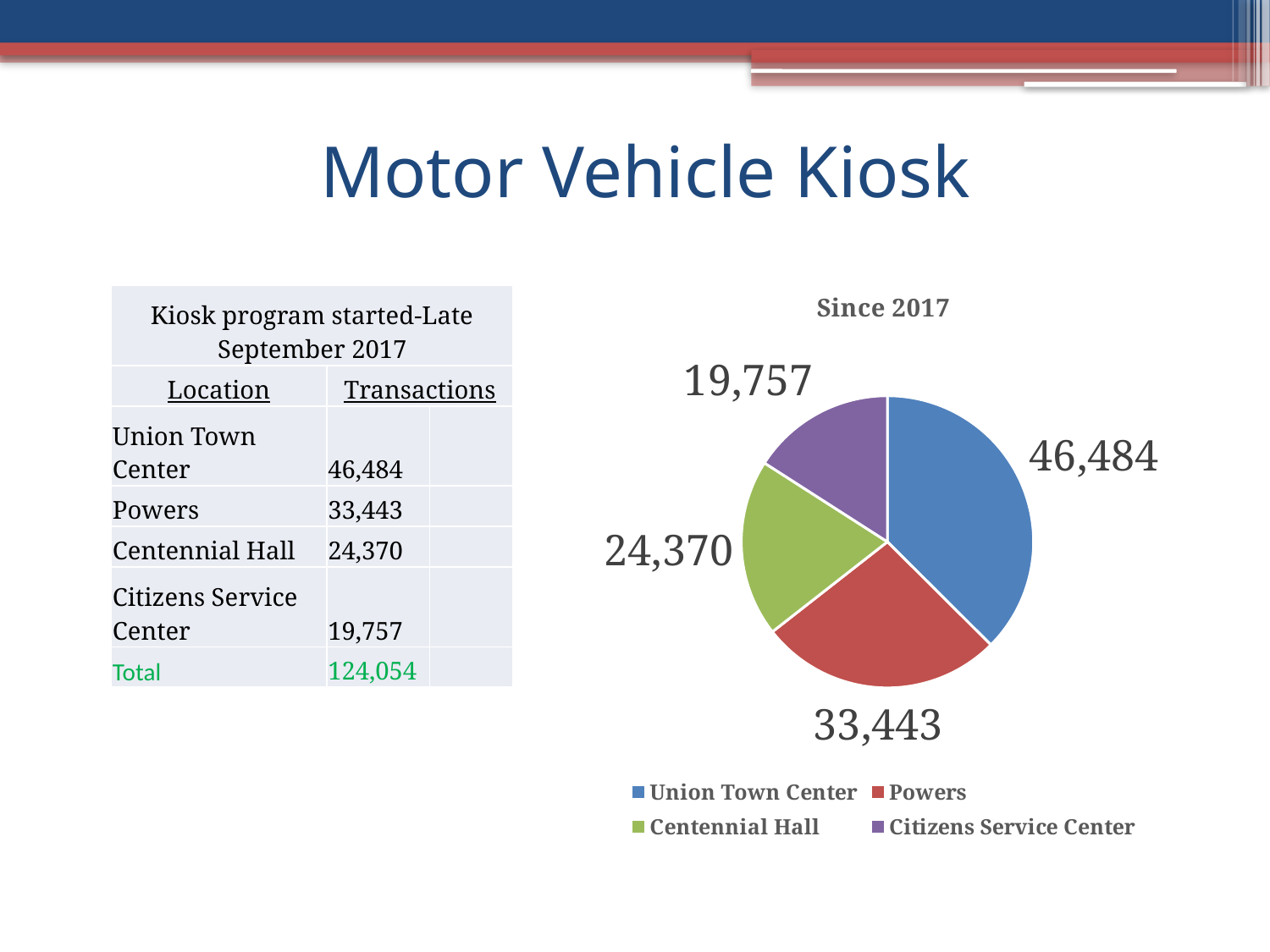
What is the value for Citizens Service Center in the pie chart? 19,757 What is the value for Powers in the pie chart? 33,443 How many slices does the pie chart have? 4 What kind of chart is shown on the slide? Pie chart What is the value for Union Town Center in the pie chart? 46,484 Which location has the largest slice in the pie chart? Union Town Center Which location has the smallest slice in the pie chart? Citizens Service Center What is the value for Centennial Hall in the pie chart? 24,370 What is the title of the pie chart? Since 2017 How many entries does the pie chart's legend list? 4 What is the difference between the values for Union Town Center and Powers in the pie chart? 13,041 Which is larger in the pie chart, Centennial Hall or Citizens Service Center? Centennial Hall